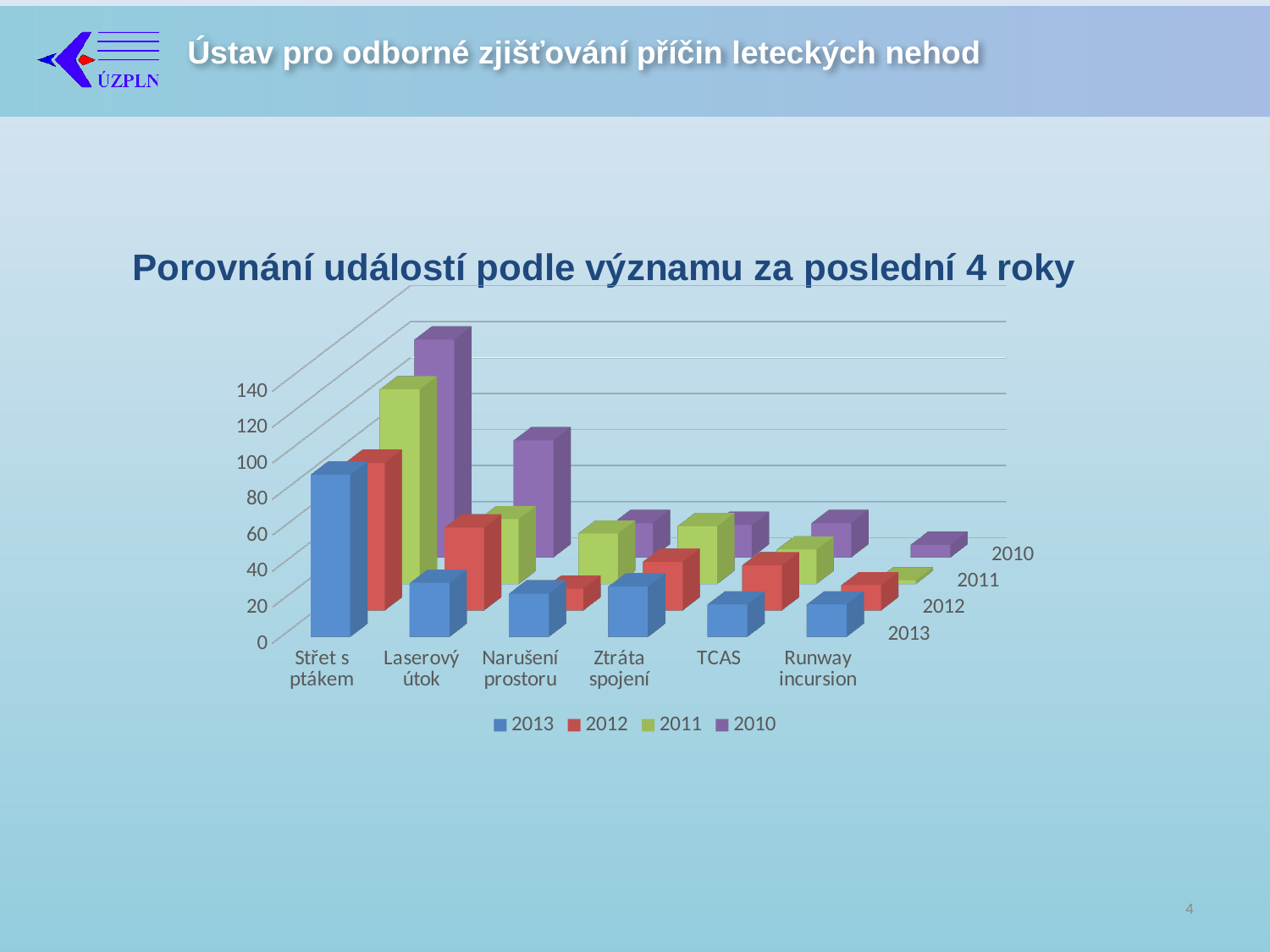
How many series does the legend list? 4 Which category has the tallest bar for the 2011 series? Střet s ptákem What kind of chart is shown on the slide? bar chart Which category has the tallest bar for the 2013 series? Střet s ptákem How many categories are shown on the x axis? 6 What is the title of the chart? Porovnání událostí podle významu za poslední 4 roky Which category has the tallest bar for the 2010 series? Střet s ptákem For the 2013 series, which is larger: Střet s ptákem or Laserový útok? Střet s ptákem For the 2010 series, which is larger: Laserový útok or Narušení prostoru? Laserový útok Which series is shown in purple according to the legend? 2010 Is the value for Laserový útok in 2013 greater or less than 80? less Is the value for Střet s ptákem in 2013 greater or less than 60? greater